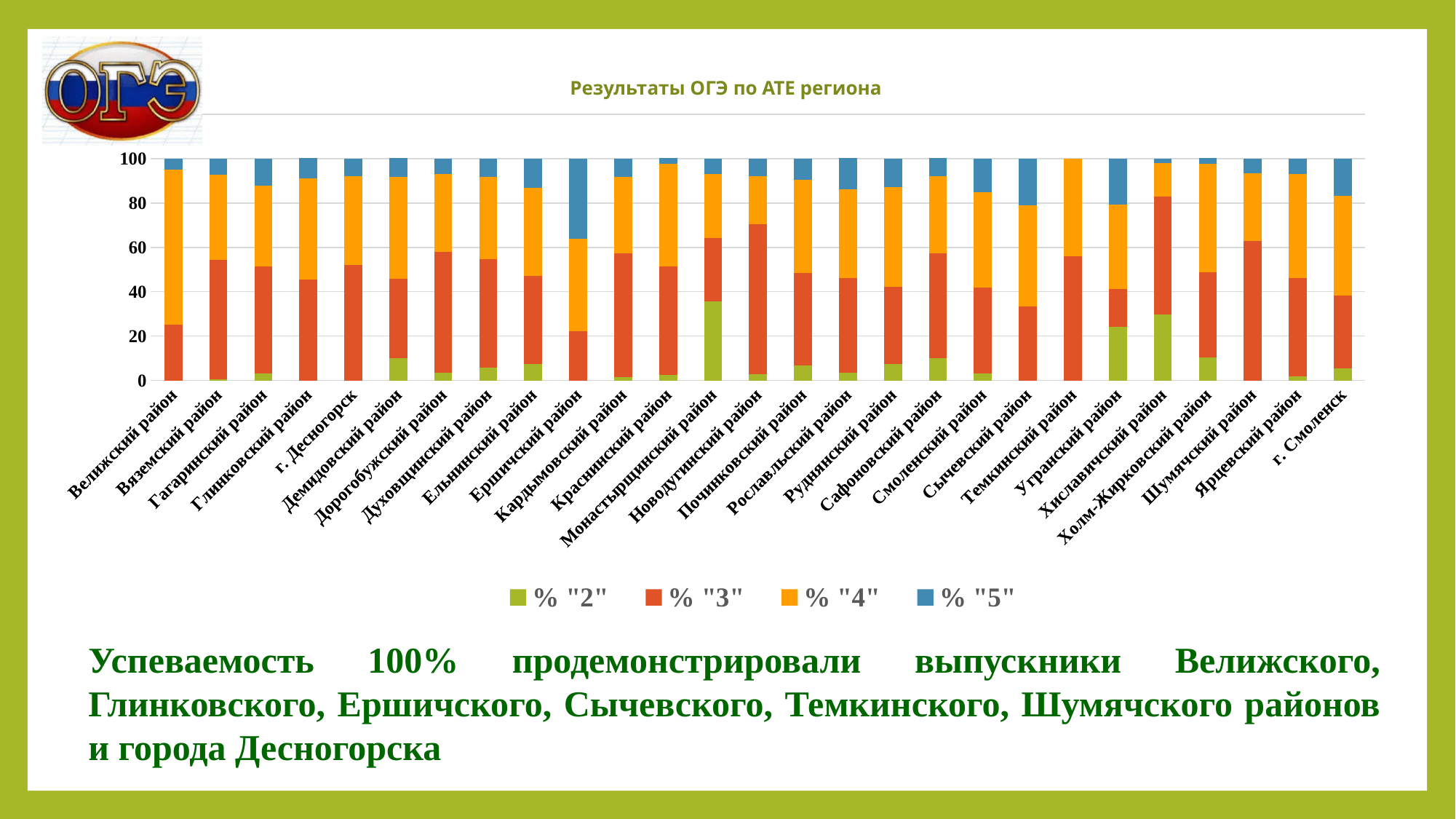
Which series is shown in blue in the legend? % "5" Is the % "2" value for Новодугинский район greater or less than 20? less What kind of chart is shown on the slide? Stacked bar chart What is the title of the chart? Результаты ОГЭ по АТЕ региона How many districts (categories) are shown along the x axis? 27 Which district has a larger % "5" share: Ершичский район or Велижский район? Ершичский район Which district has the largest % "3" (red) segment? Новодугинский район Which district has the highest share of % "5" (blue segment)? Ершичский район Is the % "3" value for Велижский район greater or less than 40? less What is the total of the stacked bar for Вяземский район? 100 How many series does the legend list? 4 Which district has the highest share of % "2" (green segment)? Монастырщинский район